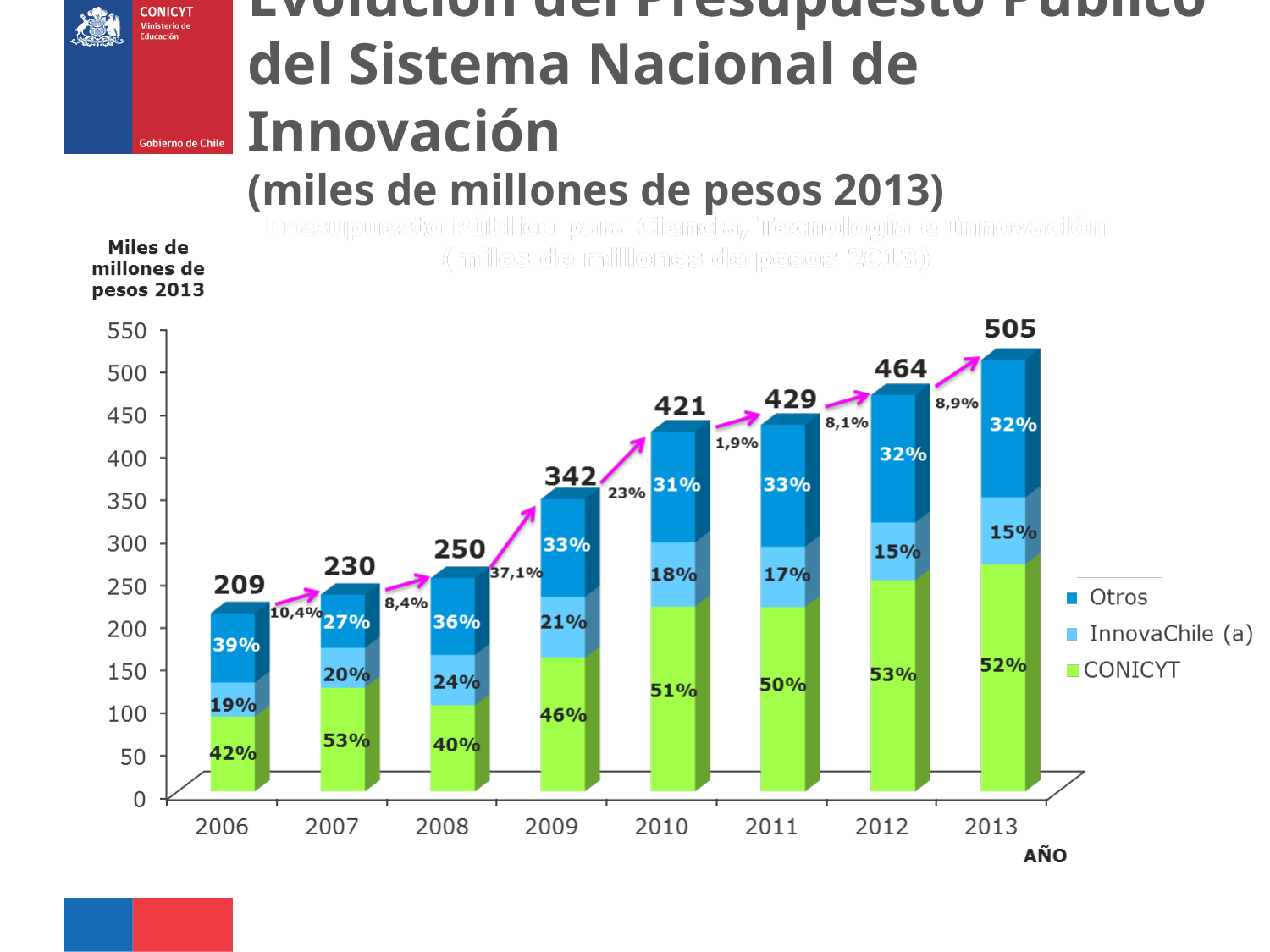
What is the difference between the total budget in 2013 and in 2006? 296 What is the total public budget shown for 2013? 505 Which year has the highest total budget? 2013 What percentage share does Otros have in 2006? 39% How many series does the legend list? 3 What percentage share does InnovaChile (a) have in 2008? 24% Which year has the lowest total budget? 2006 What percentage share does CONICYT have in 2012? 53% What kind of chart is shown on the slide? Stacked bar chart Which year has a larger total budget, 2010 or 2011? 2011 What is the total value shown above the bar for 2009? 342 How many years are shown on the x axis? 8